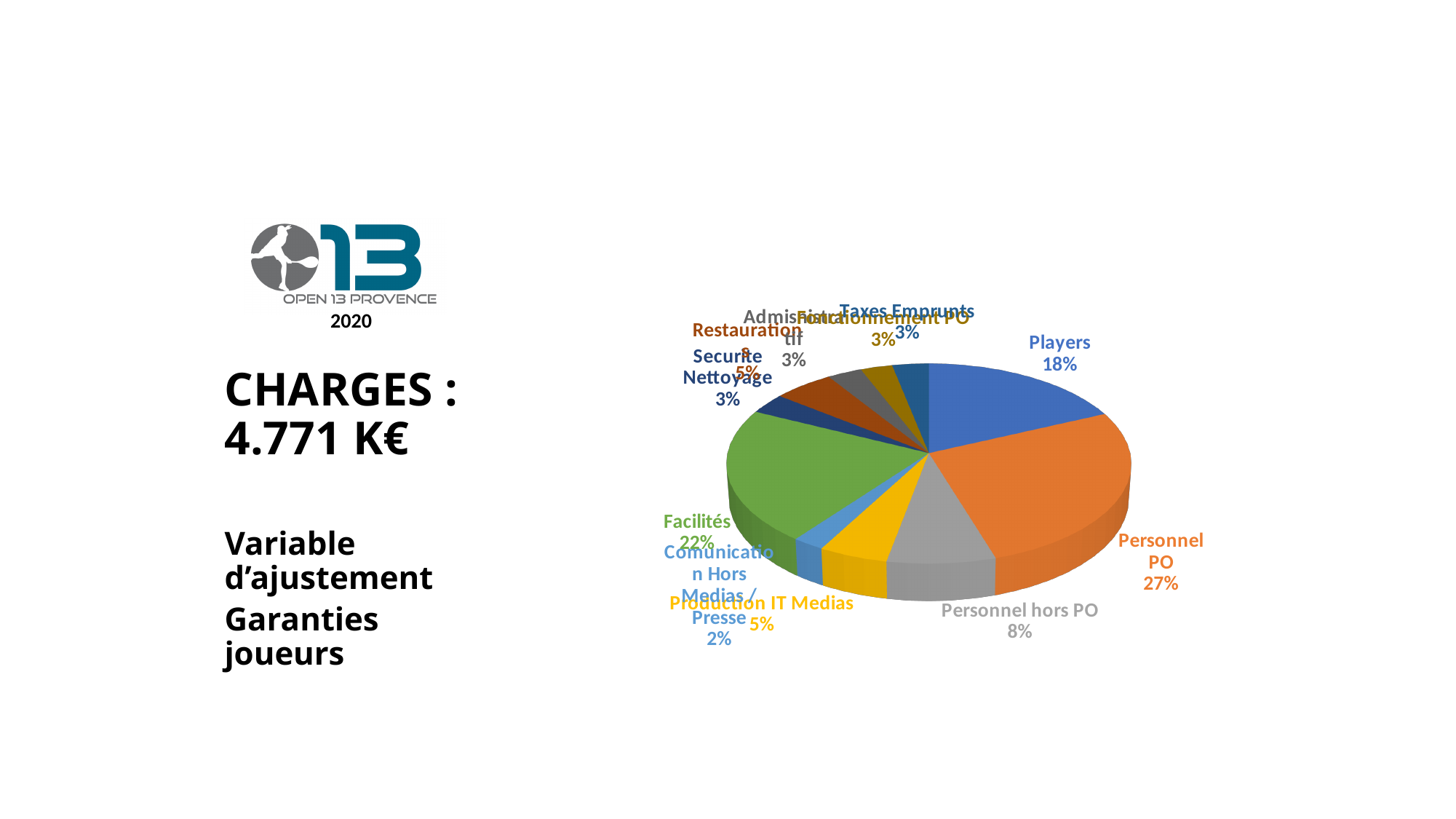
What share of the pie does Personnel PO represent? 27% Which is larger, Facilités or Players? Facilités What share of the pie does Facilités represent? 22% What type of chart is shown on the slide? pie chart Which category has the largest slice of the pie? Personnel PO What share of the pie does Players represent? 18% What is the value shown for Production IT Medias? 5% What is the difference in percentage points between Personnel PO and Players? 9% What is the value shown for Personnel hors PO? 8% Which category has the smallest slice of the pie? Comunication Hors Medias / Presse What is the value shown for Securité Nettoyage? 3% What total amount of charges is stated on the slide next to the chart? 4.771 K€